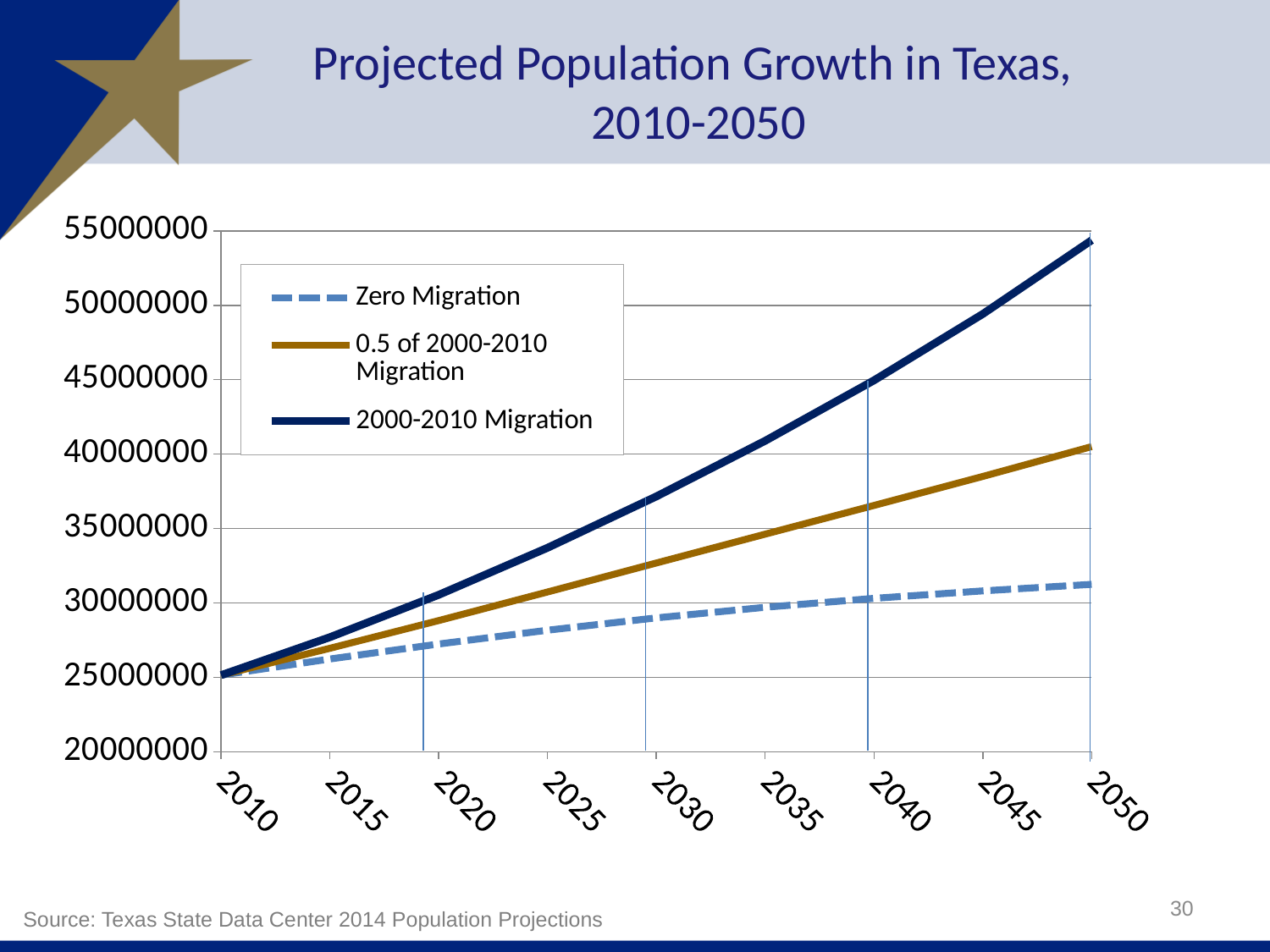
Is the value for Zero Migration in 2050 greater or less than 35000000? less How many series does the legend list? 3 Is the value for 2000-2010 Migration in 2050 greater or less than 50000000? greater In 2040, which is larger: the value for 0.5 of 2000-2010 Migration or the value for Zero Migration? 0.5 of 2000-2010 Migration How many year labels are shown on the x axis? 9 Is the value for 2000-2010 Migration in 2030 greater or less than 35000000? greater Do the values for the Zero Migration series rise or fall from 2010 to 2050? rise What kind of chart is shown on the slide? line chart Which series has the highest value in 2050? 2000-2010 Migration What is the title of the chart? Projected Population Growth in Texas, 2010-2050 Which series has the lowest value in 2050? Zero Migration